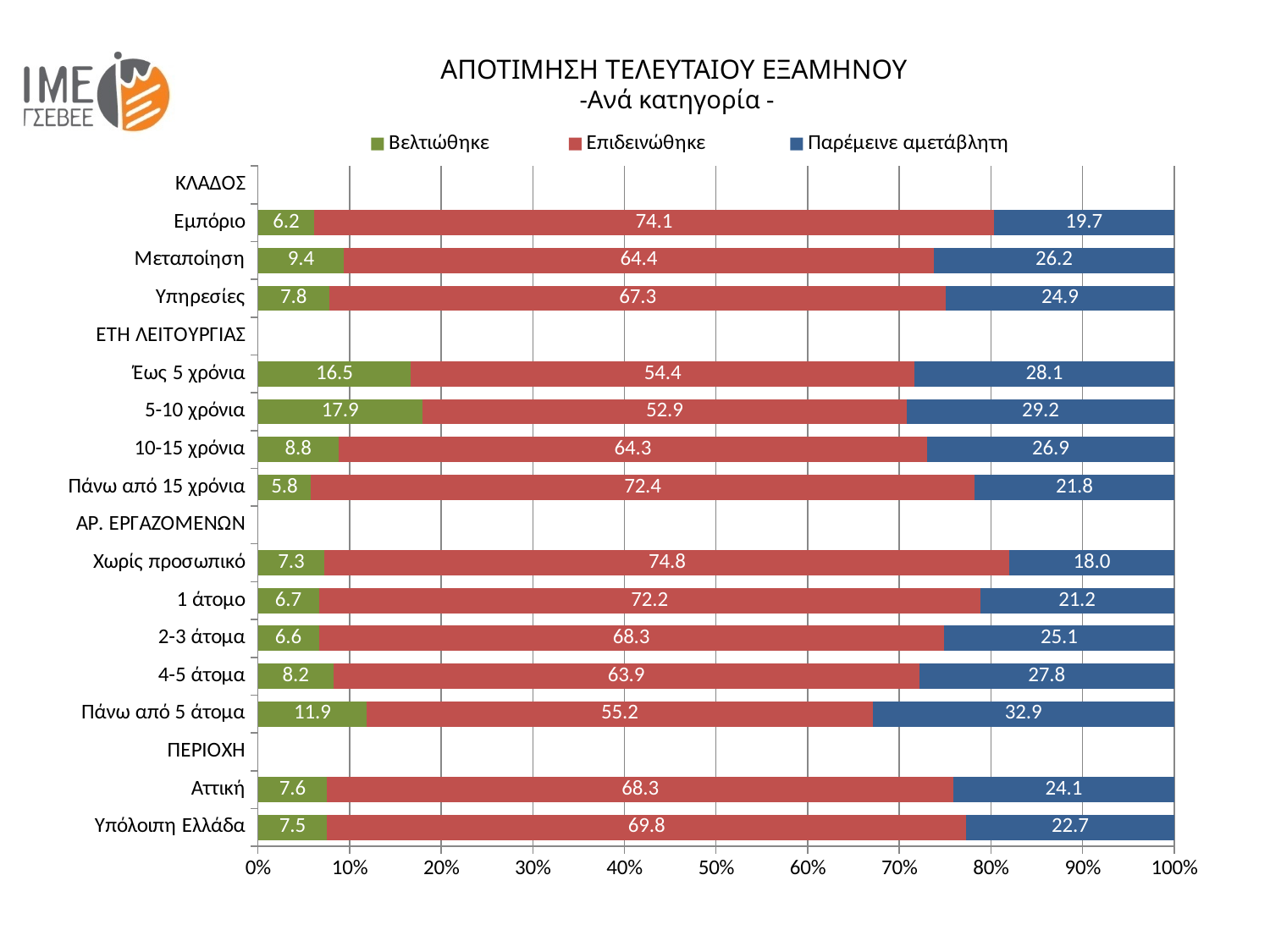
Which category has the highest Παρέμεινε αμετάβλητη value? Πάνω από 5 άτομα What is the value of Βελτιώθηκε for 5-10 χρόνια? 17.9 What is the value of Επιδεινώθηκε for Εμπόριο? 74.1 Which category has the highest Βελτιώθηκε value? 5-10 χρόνια Which has a larger Βελτιώθηκε value, Έως 5 χρόνια or 5-10 χρόνια? 5-10 χρόνια What kind of chart is shown on the slide? Stacked bar chart What is the total of the stacked bar for Πάνω από 5 άτομα? 100.0 How many series does the legend list? 3 Which category has the lowest Παρέμεινε αμετάβλητη value? Χωρίς προσωπικό What is the value of Παρέμεινε αμετάβλητη for Μεταποίηση? 26.2 What is the difference between the Επιδεινώθηκε values for Εμπόριο and Μεταποίηση? 9.7 Which category has the lowest Βελτιώθηκε value? Πάνω από 15 χρόνια